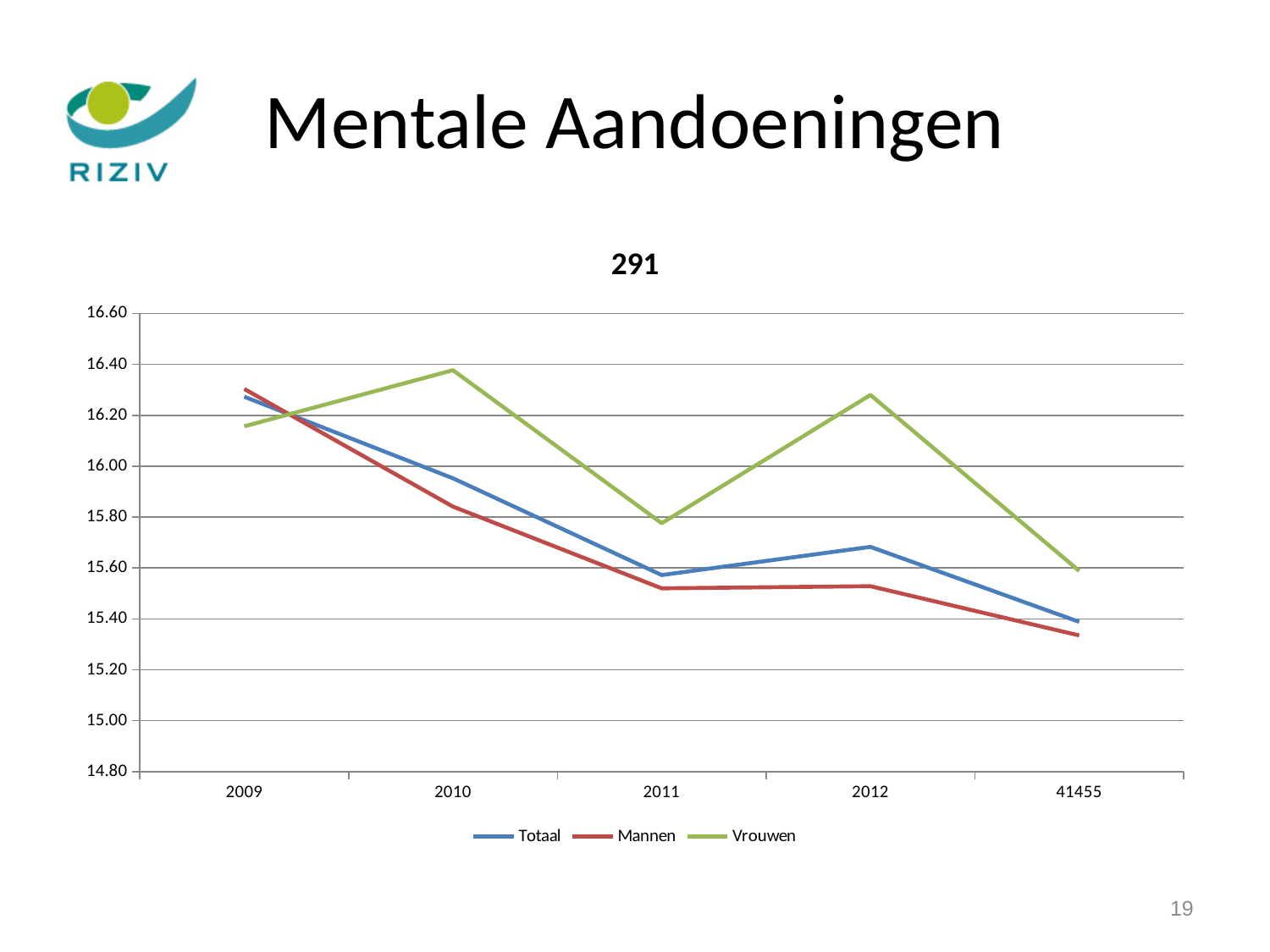
Does the Mannen series rise or fall from 2009 to 41455? fall Is the value for Vrouwen at 2012 greater or less than 16.20? greater At which x-axis category is the Vrouwen series lowest? 41455 At 2012, which is larger: Vrouwen or Mannen? Vrouwen How many series does the legend list? 3 What is the title of the chart? 291 At which x-axis category is the Vrouwen series highest? 2010 Is the value for Mannen at 2010 greater or less than 16.00? less What kind of chart is shown on the slide? line chart How many points are plotted along the x axis for each series? 5 Which series is drawn in green? Vrouwen Is the value for Vrouwen at 2011 greater or less than 16.00? less